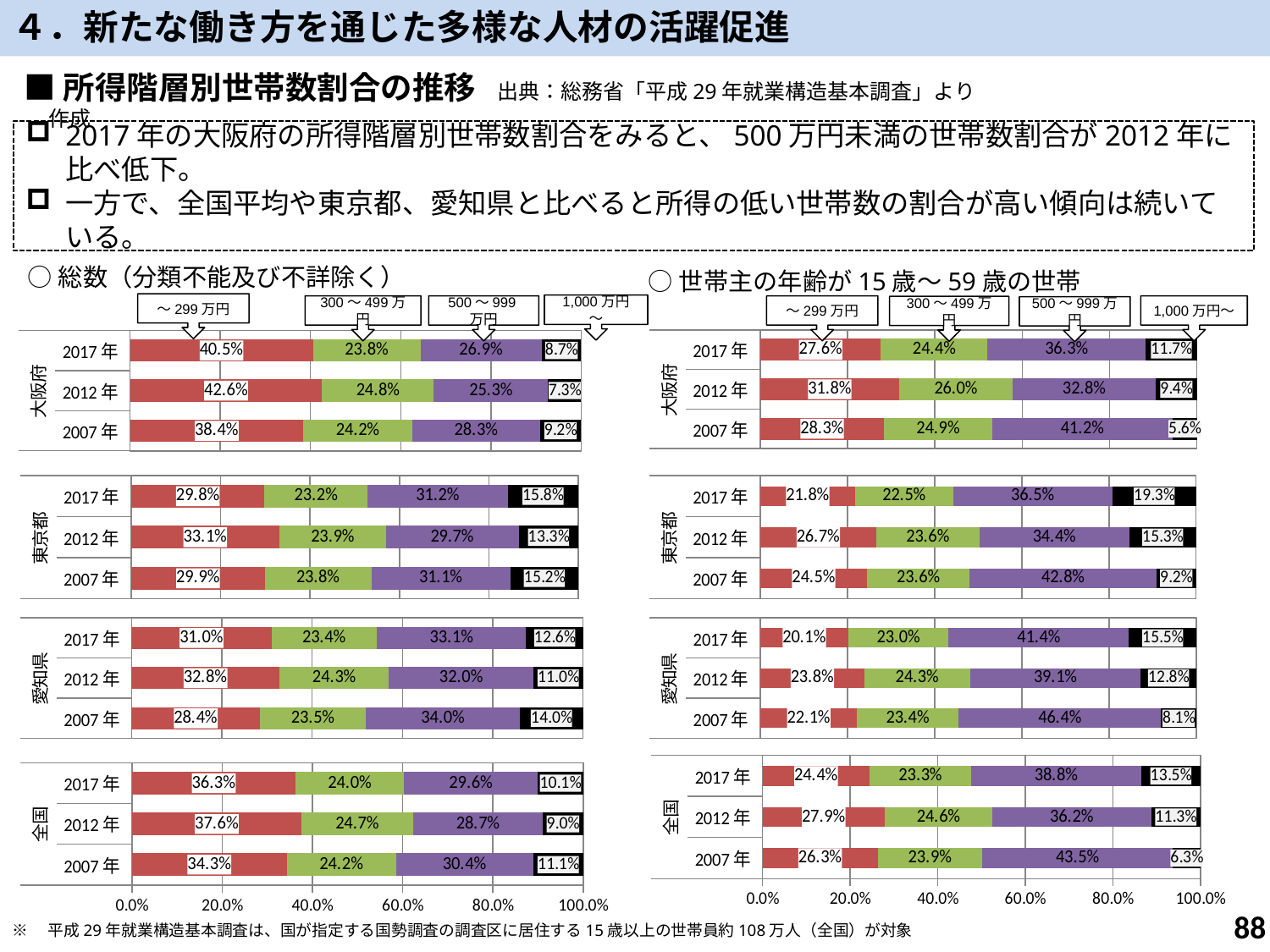
What kind of chart is the right chart (世帯主の年齢が15歳～59歳の世帯)? Stacked bar chart In the left chart (総数), what is the 1,000万円～ share for 東京都 in 2017年? 15.8% In the right chart (世帯主の年齢が15歳～59歳の世帯), what is the 500～999万円 share for 愛知県 in 2007年? 46.4% How many bars are plotted in the left chart (総数)? 12 In the left chart (総数), what is the difference between the ～299万円 share for 大阪府 in 2012年 and in 2017年? 2.1 percentage points In the left chart (総数), which year has the highest ～299万円 share for 大阪府? 2012年 In the right chart (世帯主の年齢が15歳～59歳の世帯), which year has the lowest 1,000万円～ share for 大阪府? 2007年 In the left chart (総数), what is the total of the four labelled segments for 大阪府 in 2017年? 99.9% In the left chart (総数), what is the ～299万円 share for 大阪府 in 2017年? 40.5% In the left chart (総数), which is larger for 2017年: the ～299万円 share for 大阪府 or for 全国? 大阪府 In the right chart (世帯主の年齢が15歳～59歳の世帯), does the 1,000万円～ share for 大阪府 rise or fall from 2007年 to 2017年? Rise